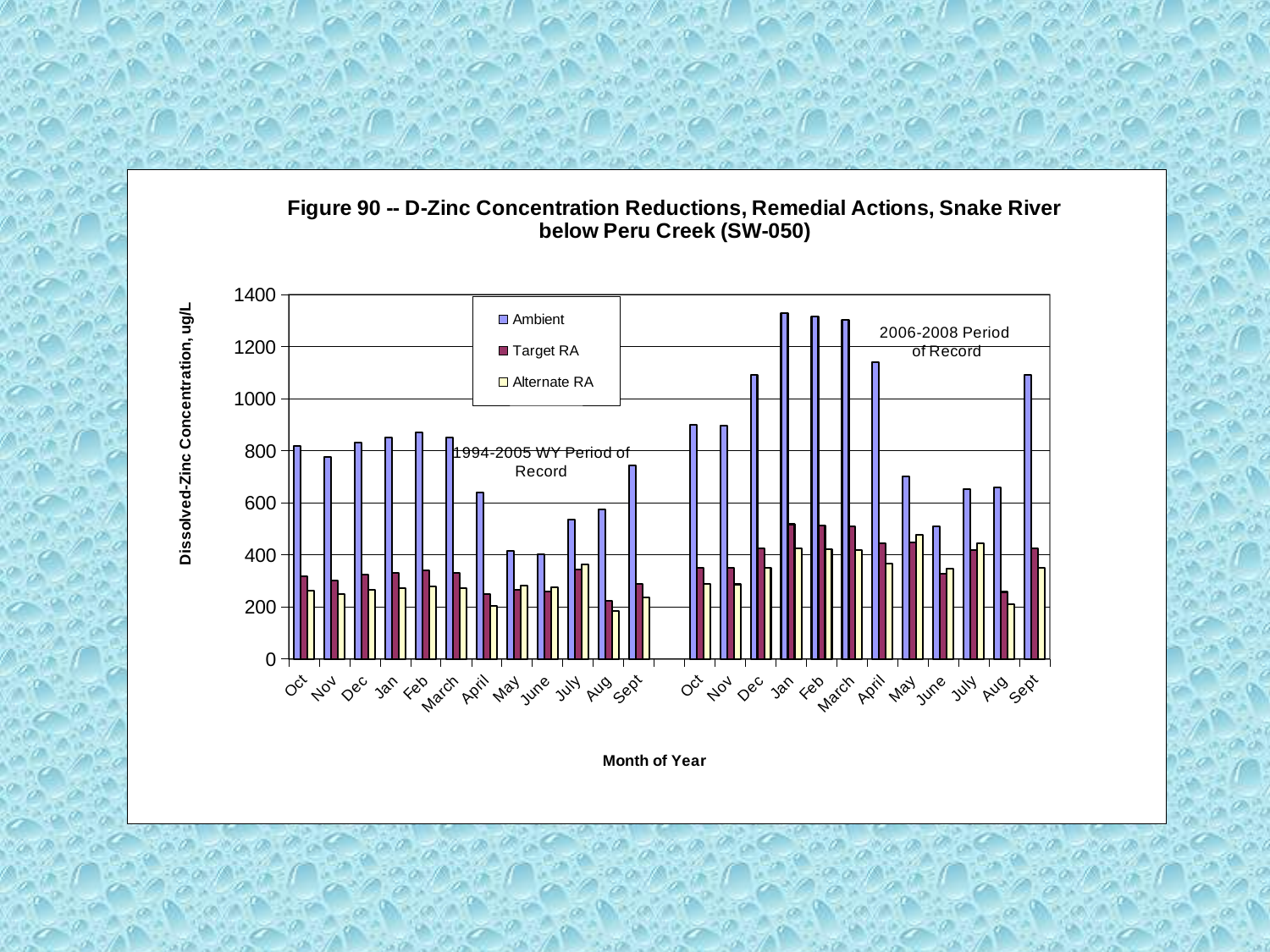
Do the Ambient values rise or fall from Jan to June in the 2006-2008 Period of Record? fall Which series are listed in the legend? Ambient, Target RA, Alternate RA What is the label on the y axis? Dissolved-Zinc Concentration, ug/L Which is larger, the Ambient value for Jan in the 1994-2005 WY Period of Record or the Ambient value for Jan in the 2006-2008 Period of Record? Jan in the 2006-2008 Period of Record How many series does the legend list? 3 What kind of chart is shown on the slide? bar chart Is the Ambient value for Dec in the 2006-2008 Period of Record greater or less than 1000? greater Is the Ambient value for April in the 1994-2005 WY Period of Record greater or less than 800? less Is the Target RA value for Jan in the 2006-2008 Period of Record greater or less than 400? greater How many months are plotted in the 2006-2008 Period of Record? 12